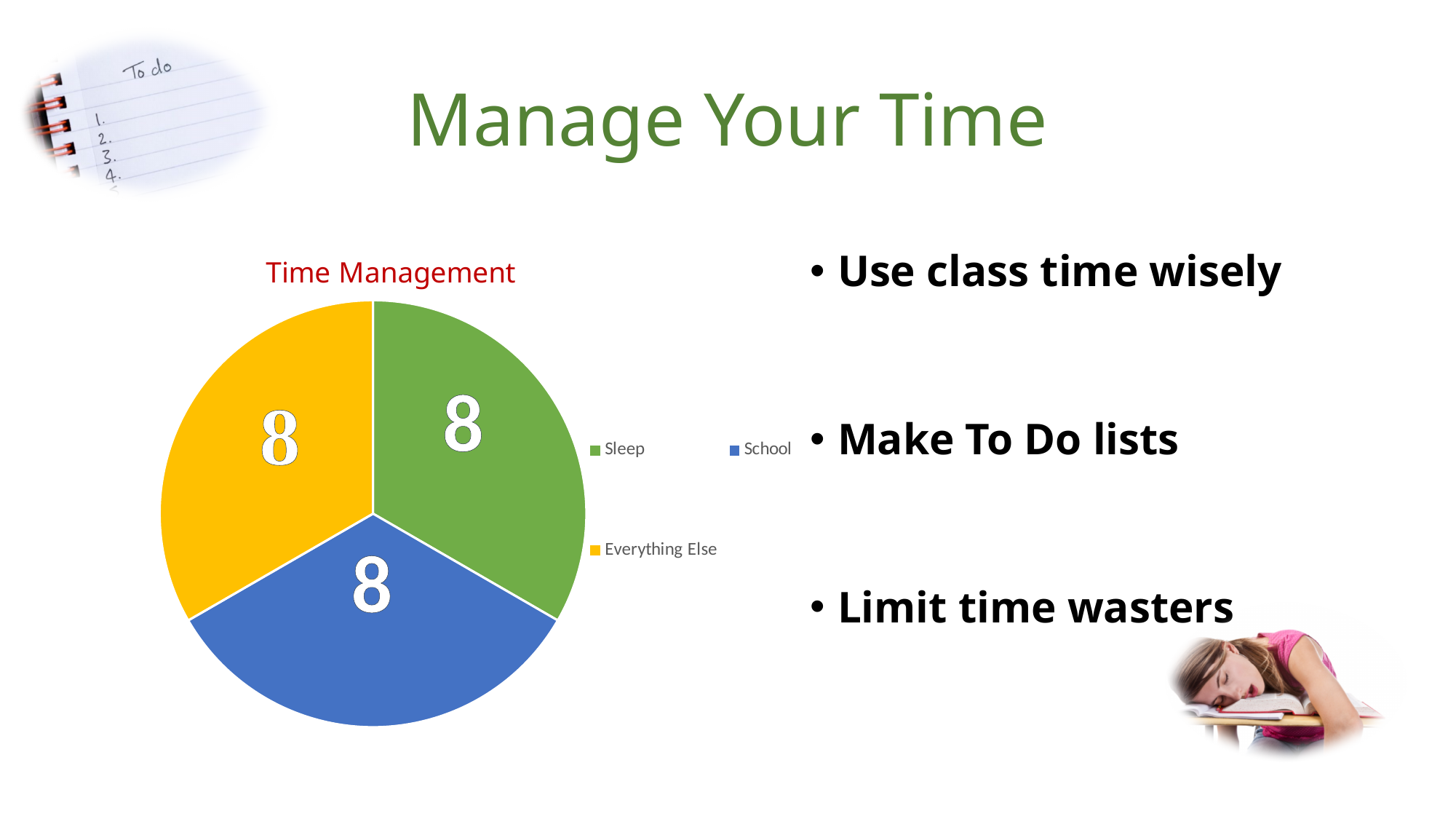
What is the difference between the values for Sleep and School? 0 Which colour represents Everything Else in the pie chart? yellow What is the value for Everything Else? 8 How many entries does the legend list? 3 What type of chart is shown on the slide? pie chart What is the total of all slices in the pie chart? 24 What is the value for Sleep? 8 What is the value for School? 8 What share of the pie does the Sleep slice represent? one third How many slices does the pie chart have? 3 What is the title of the chart? Time Management